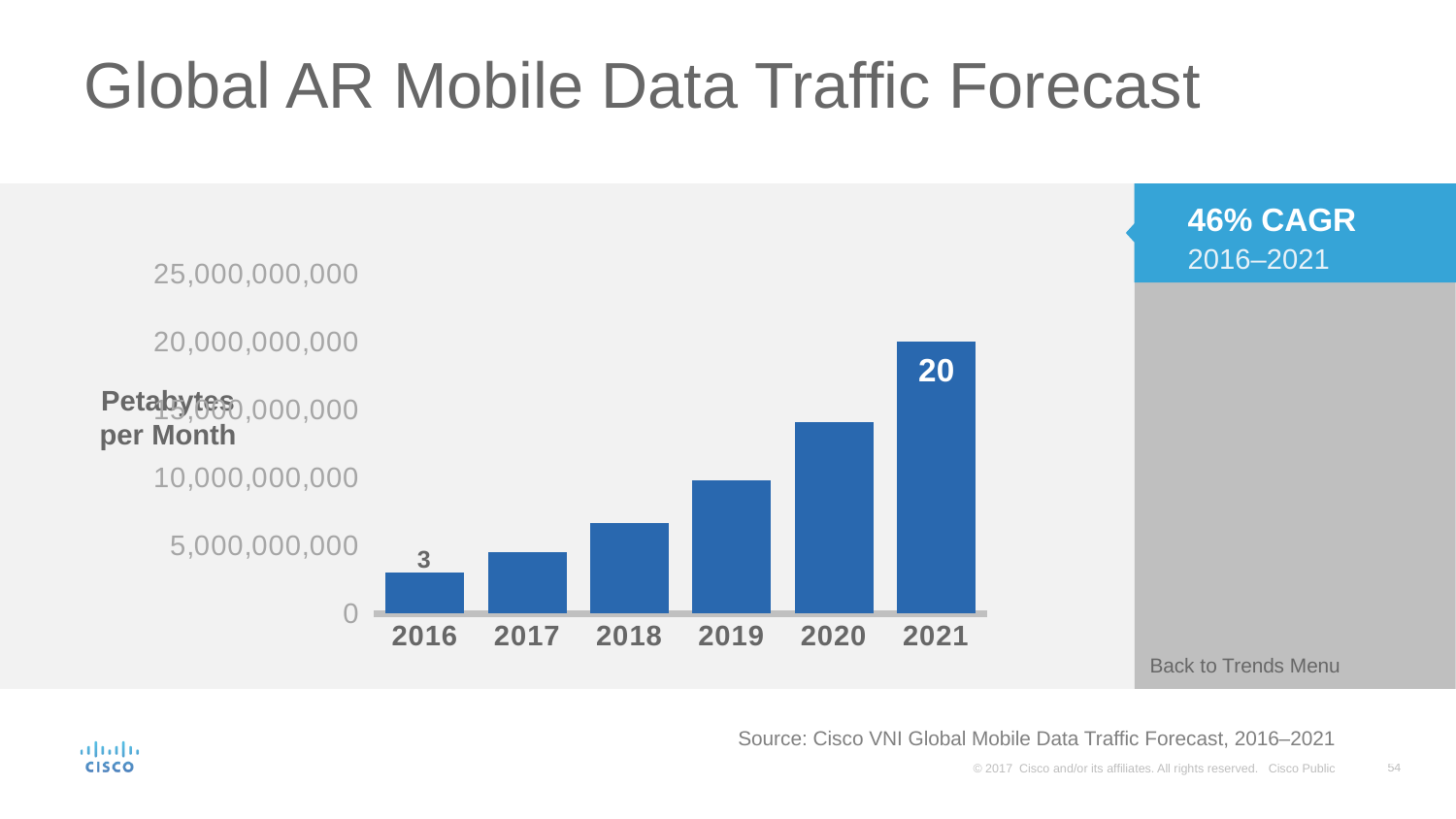
What type of chart is shown on the slide? bar chart Which is larger, the value for 2020 or the value for 2018? 2020 Which year has the lowest value? 2016 Which year has the highest value? 2021 What is the data label shown on the bar for 2021? 20 What is the difference between the labelled values for 2021 and 2016? 17 What CAGR is stated for 2016–2021 on the slide? 46% CAGR How many years are shown on the x axis? 6 What is the data label shown on the bar for 2016? 3 Is the value for 2020 greater or less than 10,000,000,000? greater Do the values rise or fall from 2016 to 2021? rise